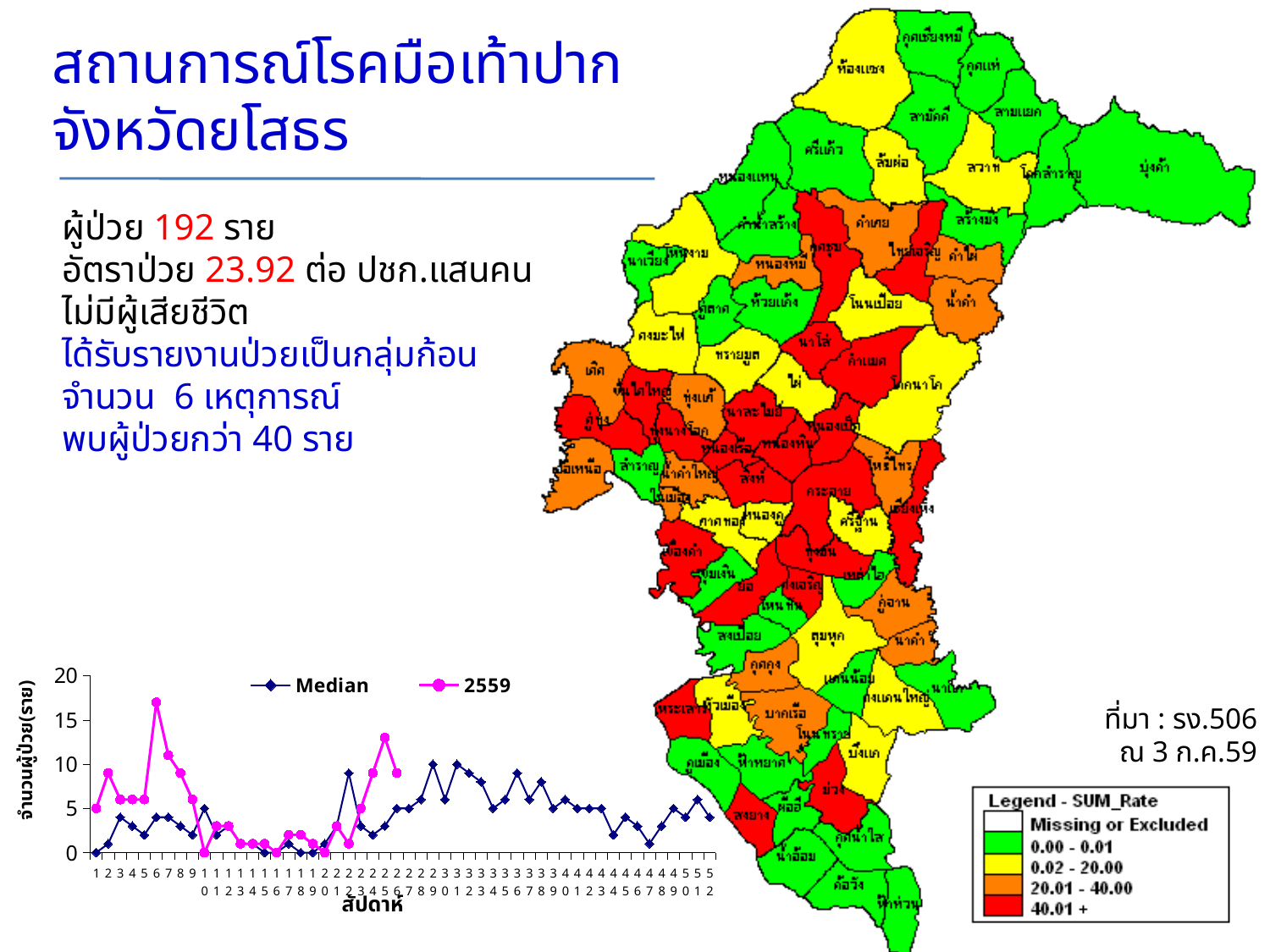
In which week does the 2559 series reach its highest value? week 6 How many series does the legend of the line chart list? 2 Is the value of the Median series at week 6 greater or less than 10? less At week 20, which series has the higher value, Median or 2559? Median Is the value of the 2559 series at week 6 greater or less than 15? greater What kind of chart is shown at the bottom left of the slide? line chart What are the two series named in the legend of the line chart? Median and 2559 How many weeks are marked along the x axis of the line chart? 52 Between week 22 and week 25, does the 2559 series rise or fall? rise What is the label of the x axis of the line chart? สัปดาห์ At week 6, which series has the higher value, Median or 2559? 2559 Is the value of the 2559 series at week 25 greater or less than 10? greater